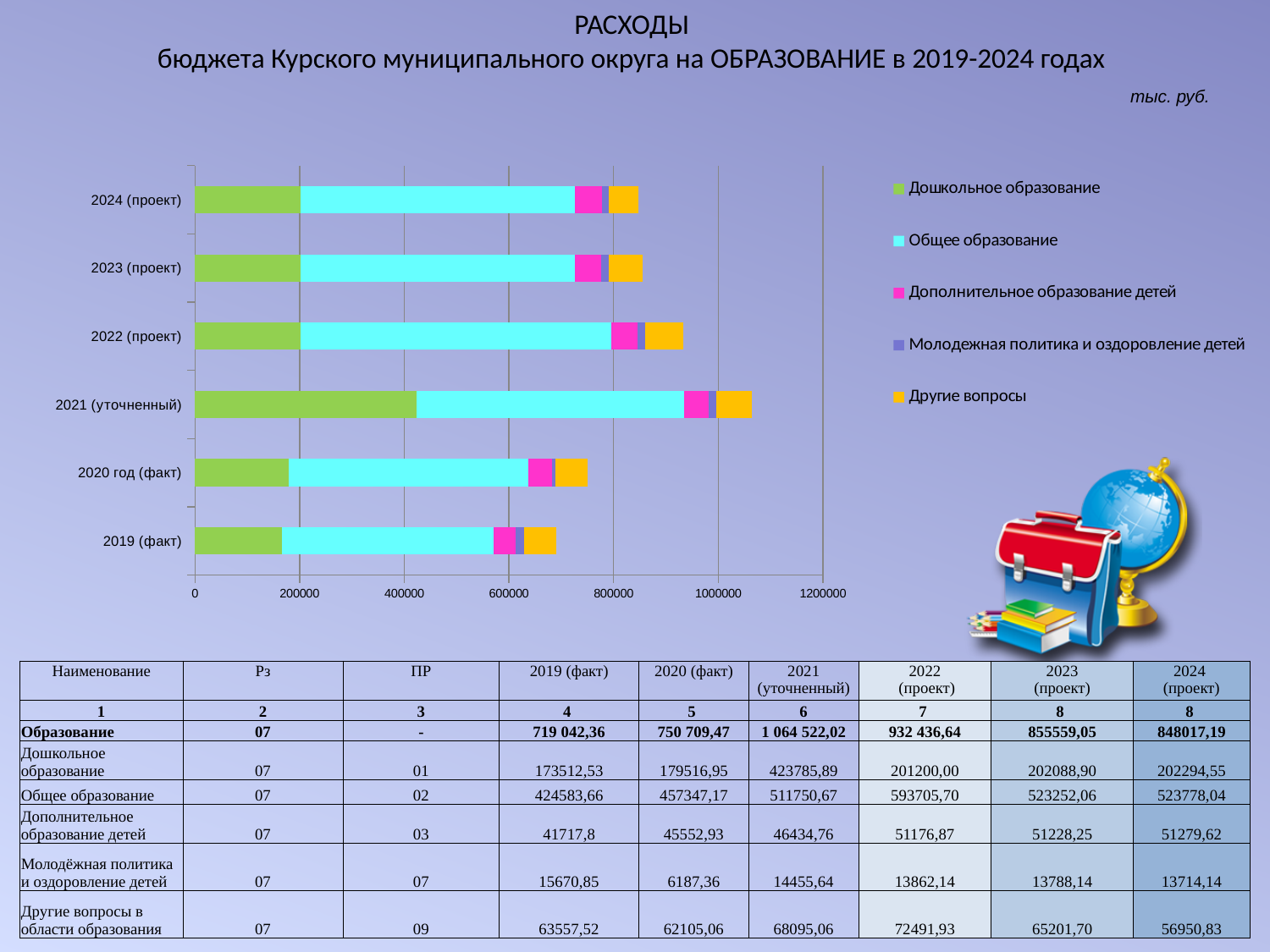
What is the value of Дошкольное образование for 2021 (уточненный)? 423785,89 Which year has the shortest total bar on the chart? 2019 (факт) What is the value of Общее образование for 2022 (проект)? 593705,70 What is the difference between Общее образование in 2020 (факт) and in 2019 (факт)? 32763,51 Which year has the longest total bar on the chart? 2021 (уточненный) Which legend entry is shown in cyan on the chart? Общее образование Is the total bar for 2019 (факт) greater or less than 800000? less Is the total bar for 2021 (уточненный) greater or less than 1000000? greater How many series does the chart legend list? 5 What kind of chart is shown on the slide? bar chart Which is larger, the Дошкольное образование segment for 2021 (уточненный) or for 2020 год (факт)? 2021 (уточненный) How many year categories are plotted on the chart? 6